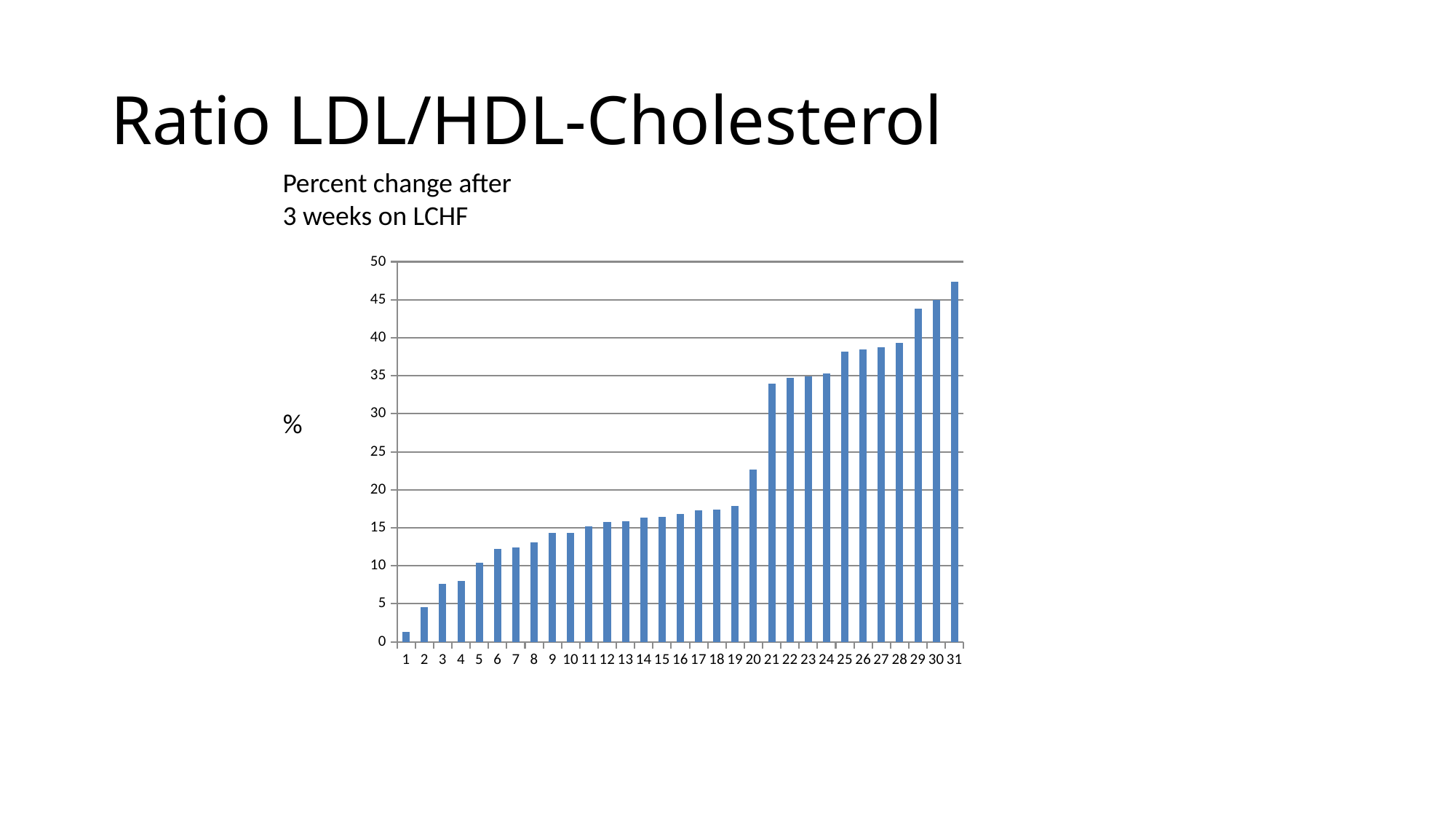
Is the value for category 20 greater or less than 25? less Which category has the highest value on the chart? 31 How many bars (categories) are plotted on the chart? 31 Is the value for category 31 greater or less than 45? greater What is the title of the slide above the chart? Ratio LDL/HDL-Cholesterol Is the value for category 2 greater or less than 5? less Which category has the lowest value on the chart? 1 Do the values rise or fall as you move from category 1 to category 31 along the x axis? rise Which has the larger value, category 5 or category 19? 19 What kind of chart is shown on the slide? bar chart Which has the larger value, category 10 or category 25? 25